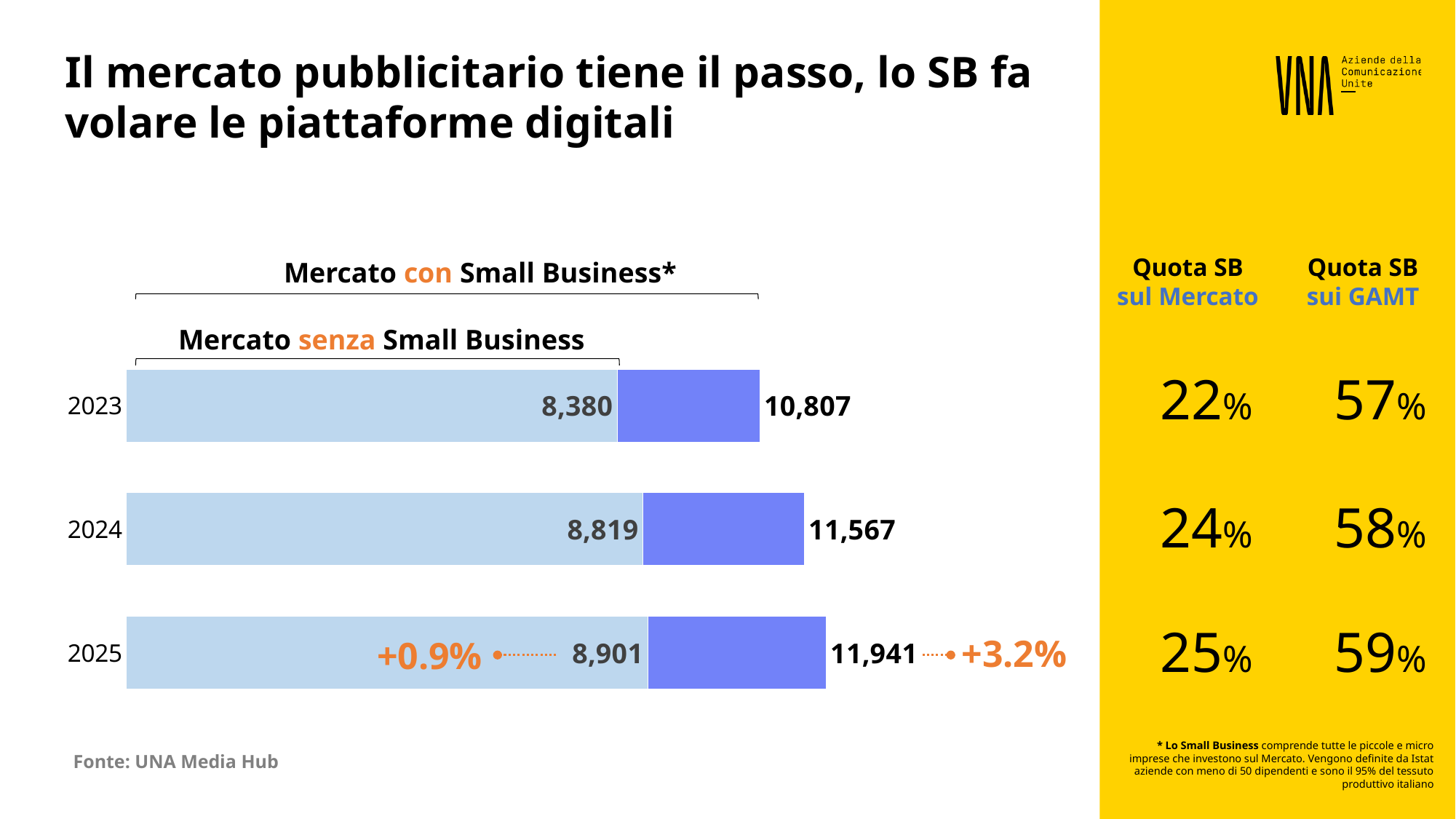
Do the values for the market with Small Business rise or fall from 2023 to 2025? Rise What is the value of the market without Small Business (Mercato senza Small Business) for 2023? 8,380 What is the difference between the market with Small Business and the market without Small Business in 2023? 2,427 How many years are shown in the chart? 3 What percentage growth is shown for the market with Small Business in 2025? +3.2% What is the value of the market with Small Business (Mercato con Small Business*) for 2025? 11,941 Which year has the highest value for the market with Small Business? 2025 What kind of chart is shown on the slide? Stacked horizontal bar chart Which year has the lowest value for the market without Small Business? 2023 By how much did the market with Small Business grow from 2024 to 2025? 374 What is the value of the market without Small Business for 2024? 8,819 Is the market with Small Business larger in 2024 or in 2023? 2024